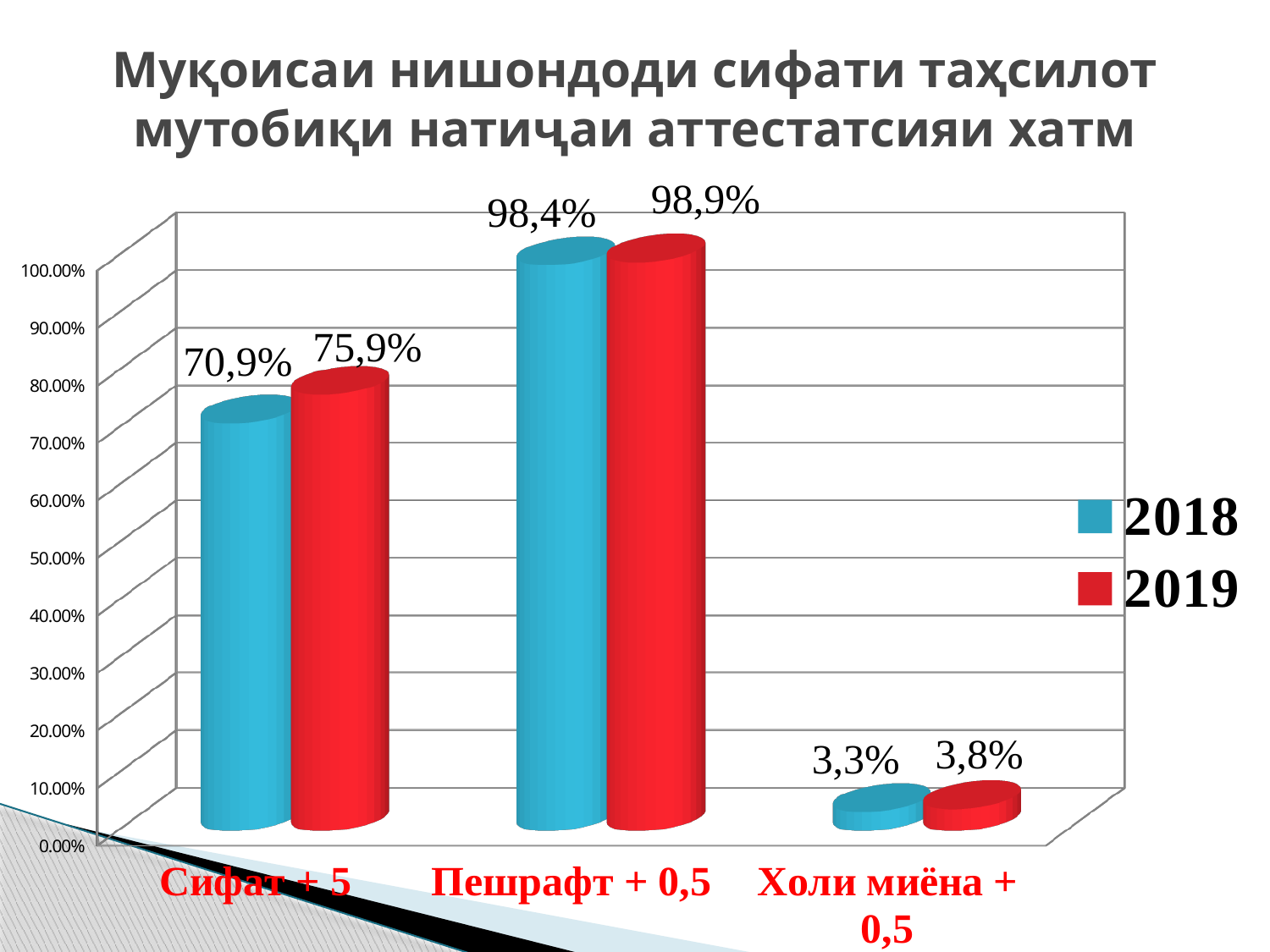
How many series does the legend list? 2 What is the 2018 value for Пешрафт + 0,5? 98,4% How many categories are shown on the x axis? 3 Which category has the lowest 2018 value? Холи миёна + 0,5 What is the 2019 value for Холи миёна + 0,5? 3,8% What is the difference between the 2019 and 2018 values for Сифат + 5? 5,0% What is the 2018 value for Сифат + 5? 70,9% Which category has the highest 2019 value? Пешрафт + 0,5 Which colour represents the 2019 series in the legend? red Which is larger for Сифат + 5, the 2018 value or the 2019 value? 2019 What kind of chart is shown on the slide? bar chart What is the 2019 value for Сифат + 5? 75,9%